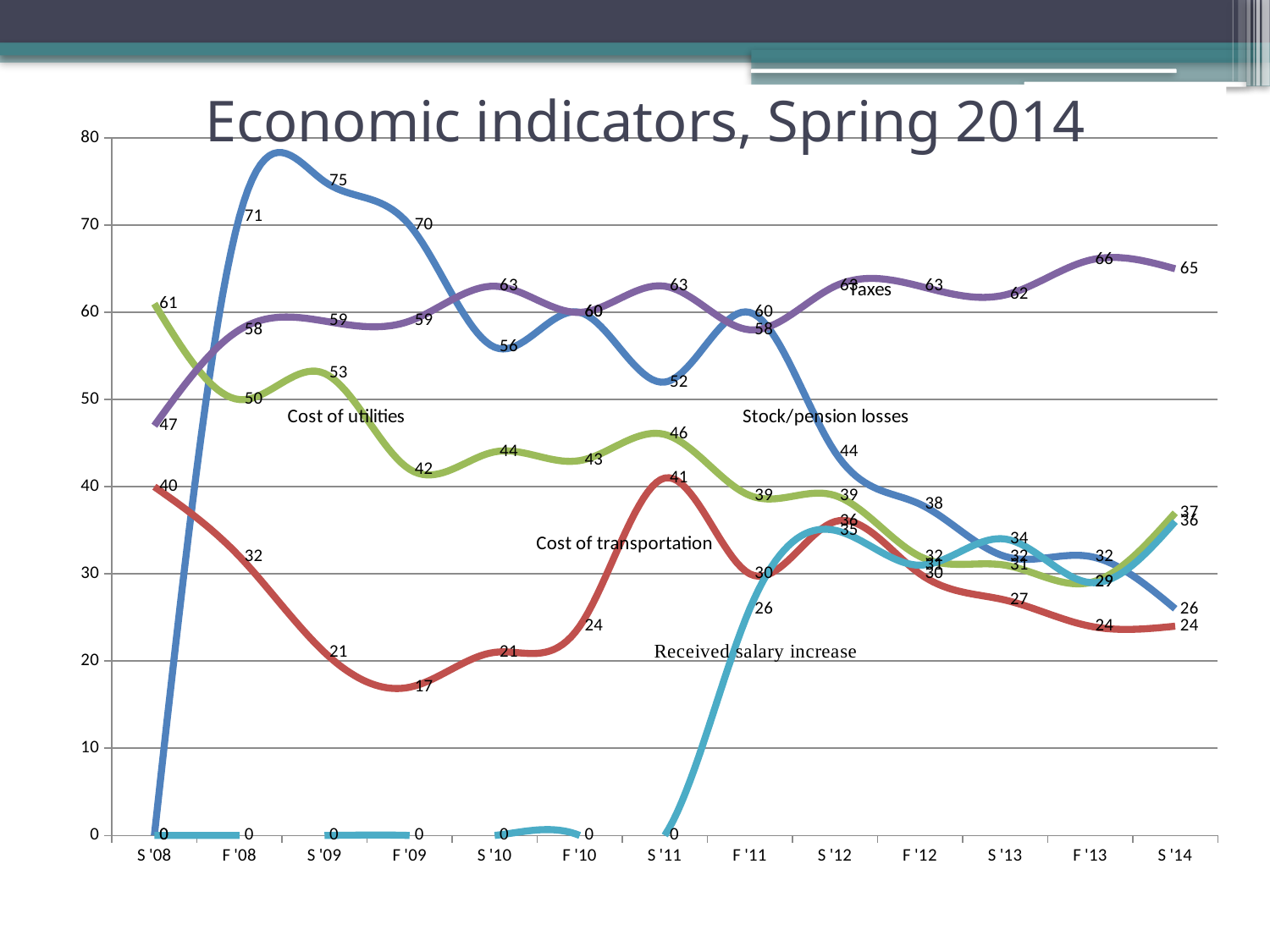
What kind of chart is shown on the slide? line chart What is the title of the chart? Economic indicators, Spring 2014 What is the value for Stock/pension losses at S '09? 75 How many time points are shown along the x axis? 13 What is the difference between Stock/pension losses at F '08 and at S '14? 45 What is the value for Taxes at S '14? 65 What is the value for Cost of utilities at S '08? 61 At which time point does Cost of transportation reach its lowest value? F '09 What is the value for Cost of transportation at F '09? 17 What is the value for Received salary increase at F '11? 26 At S '11, which is larger: Taxes or Stock/pension losses? Taxes At which time point does Stock/pension losses reach its highest value? S '09